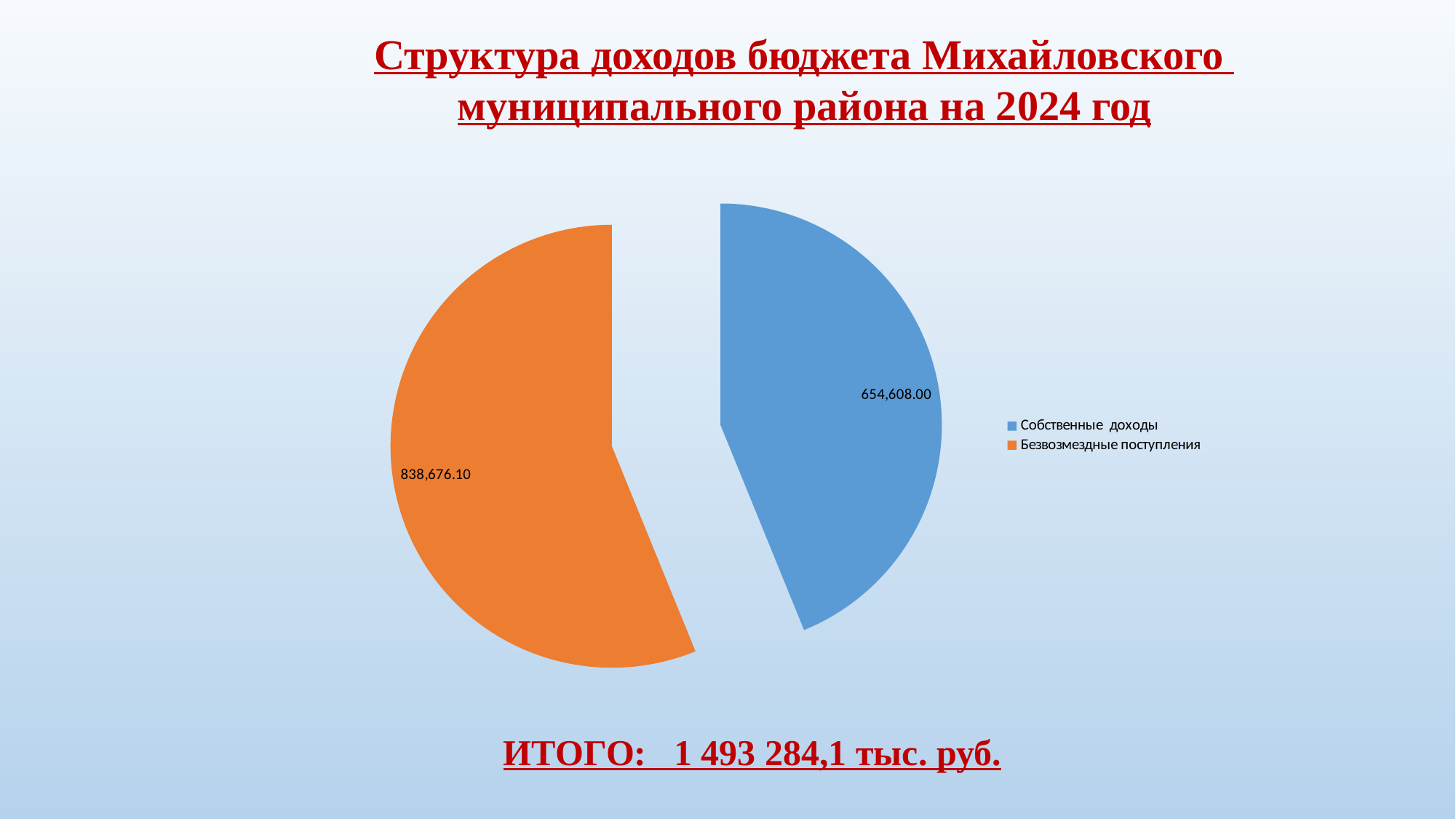
What is the value for Безвозмездные поступления? 838,676.10 What type of chart is shown on the slide? pie chart How many slices does the pie chart have? 2 How many entries does the legend list? 2 What total (ИТОГО) is stated on the slide for the budget revenues? 1 493 284,1 тыс. руб. What is the value for Собственные доходы? 654,608.00 Which category has the largest slice of the pie? Безвозмездные поступления What colour is the slice for Собственные доходы? blue Which category has the smallest slice of the pie? Собственные доходы What is the difference between Безвозмездные поступления and Собственные доходы? 184,068.10 Which is larger: Собственные доходы or Безвозмездные поступления? Безвозмездные поступления What share of the total do Безвозмездные поступления represent, to the nearest whole percent? 56%